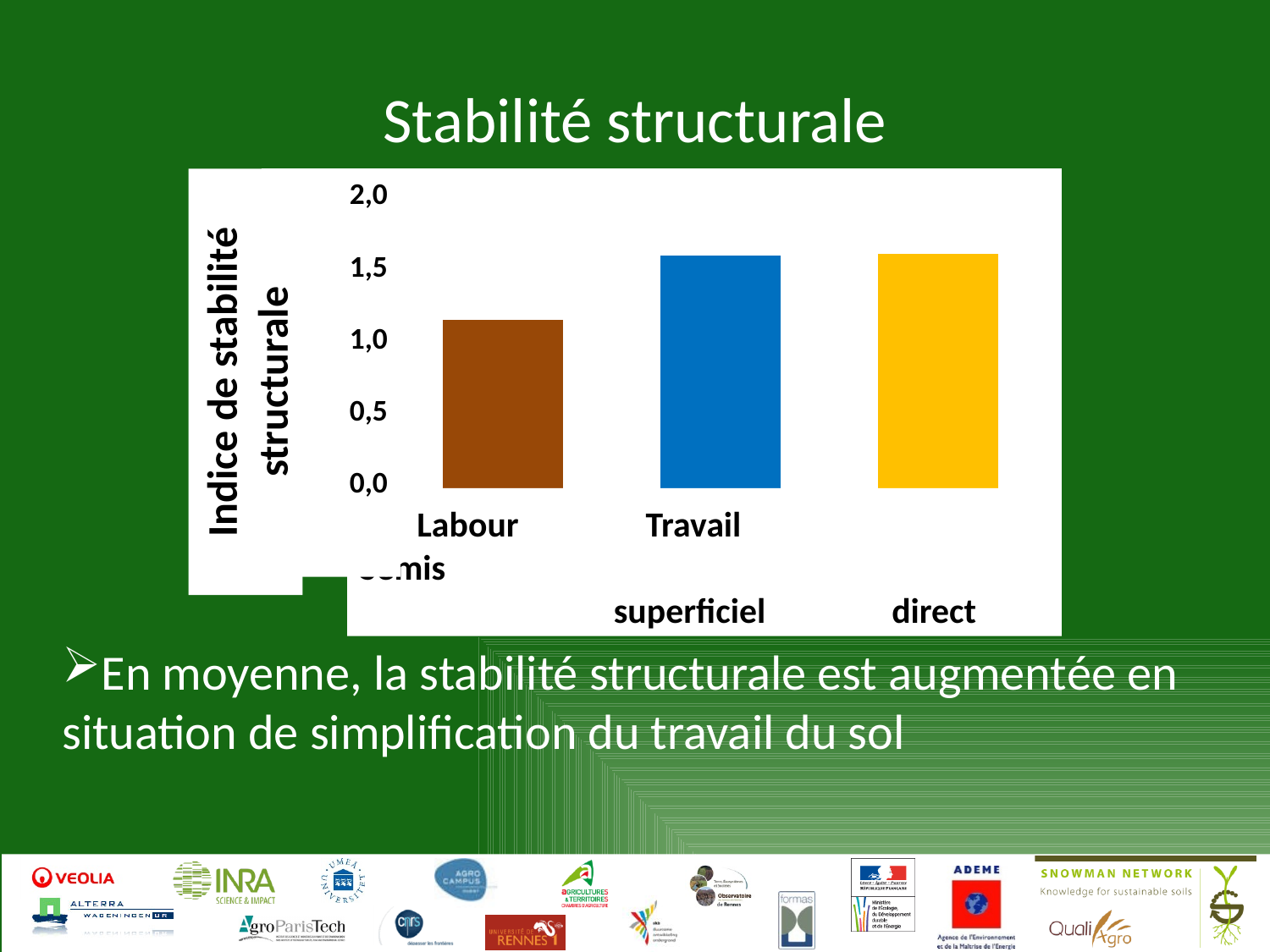
Is the value for Labour greater or less than 1,0? greater Which is larger, the value for Labour or the value for Travail superficiel? Travail superficiel Is the value for Labour greater or less than 1,5? less What kind of chart is shown on the slide? bar chart What is the label of the vertical axis? Indice de stabilité structurale Which category has the lowest structural stability index? Labour What is the highest value shown on the vertical axis? 2,0 How many bars (categories) does the chart show? 3 Is the value for Semis direct greater or less than 2,0? less What is the title of the chart? Stabilité structurale